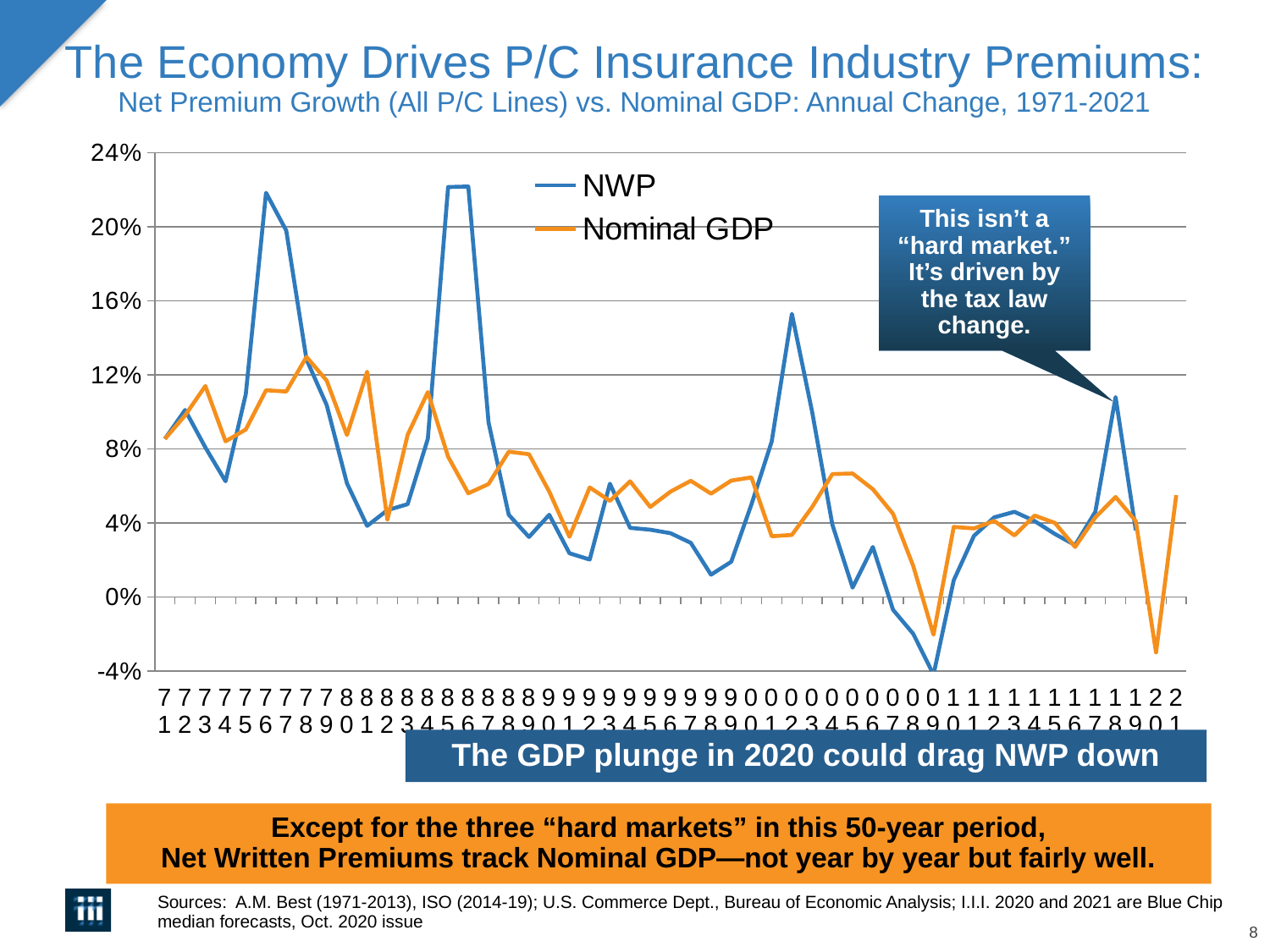
In which year does NWP reach its lowest value? 2009 Is the NWP value for 2009 greater or less than 0%? less What are the two series named in the legend? NWP and Nominal GDP Is the NWP value for 1985 greater or less than 20%? greater Is the NWP value for 2002 greater or less than 12%? greater What kind of chart is shown on the slide? Line chart Which series is drawn in orange? Nominal GDP In which year does Nominal GDP reach its lowest value? 2020 How many series does the legend list? 2 How many years are plotted along the x axis? 51